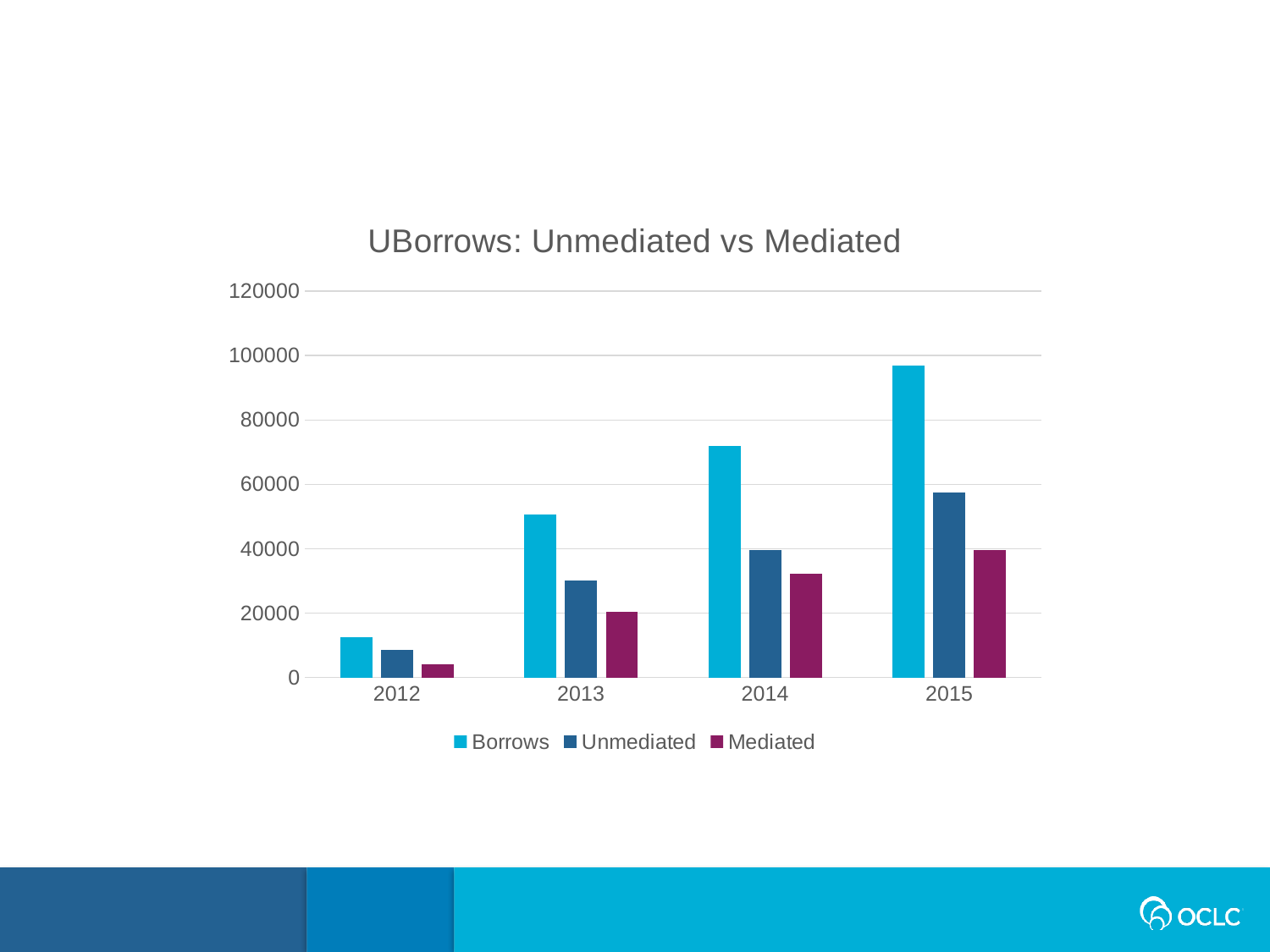
Do the Borrows values rise or fall from 2012 to 2015? rise What is the title of the chart? UBorrows: Unmediated vs Mediated Is the Borrows value for 2015 greater or less than 80000? greater Is the Borrows value for 2012 greater or less than 20000? less Is the Mediated value for 2014 greater or less than 20000? greater In which year is the Mediated value lowest? 2012 In which year is the Borrows value highest? 2015 How many years are shown on the x axis? 4 In 2015, which is larger: the Unmediated value or the Mediated value? Unmediated What type of chart is shown on the slide? bar chart How many series does the legend list? 3